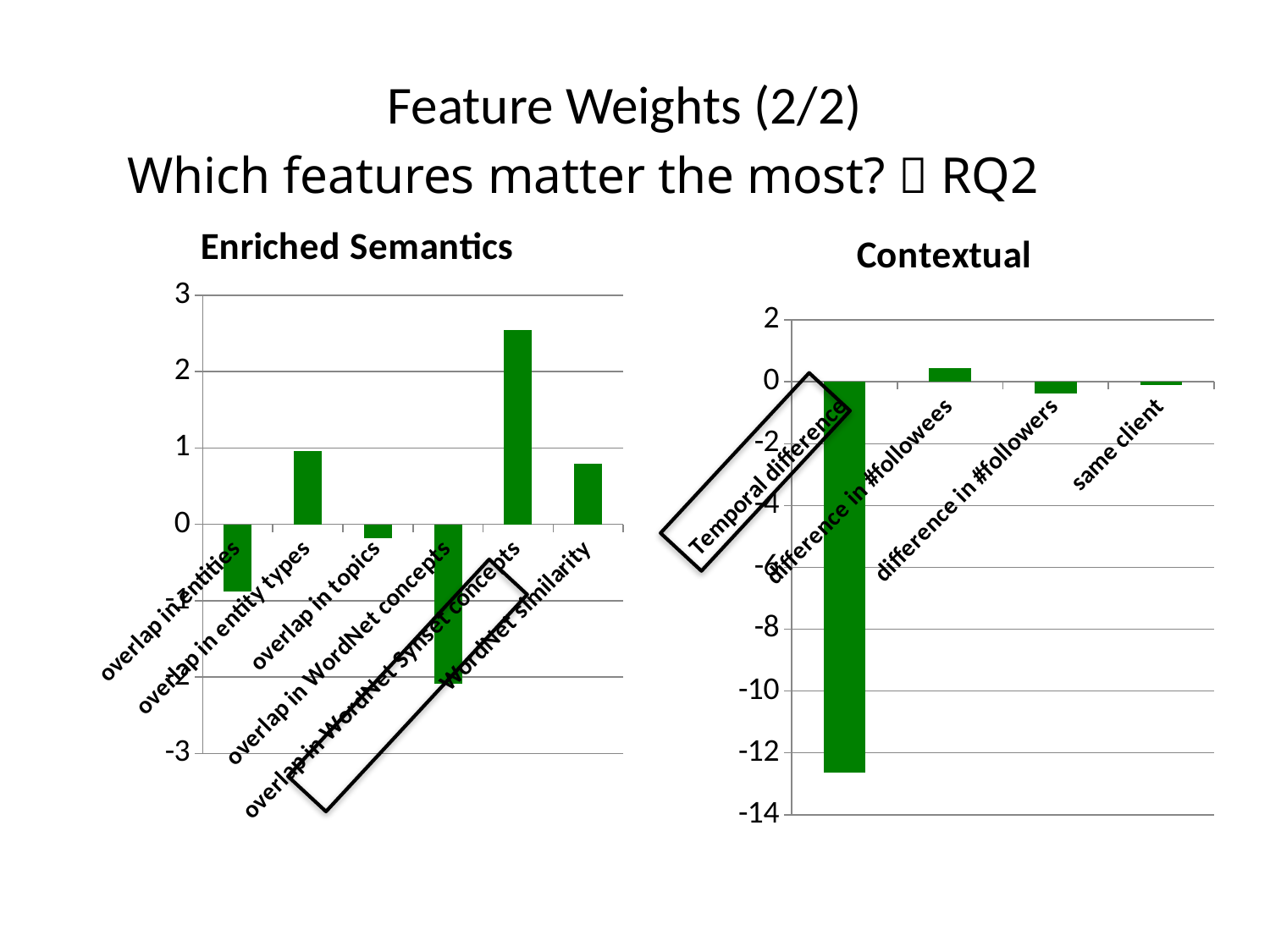
What kind of chart is the Enriched Semantics chart? bar chart In the Contextual chart, which category has the lowest value? Temporal difference In the Contextual chart, which category has the highest value? difference in #followees In the Contextual chart, is the value for Temporal difference greater or less than -10? less In the Enriched Semantics chart, which category has the highest value? overlap in WordNet Synset concepts In the Enriched Semantics chart, which category has the lowest value? overlap in WordNet concepts How many categories are plotted in the Contextual chart? 4 In the Enriched Semantics chart, is the value for overlap in WordNet concepts greater or less than -1? less What is the title of the chart on the right side of the slide? Contextual In the Enriched Semantics chart, is the value for overlap in WordNet Synset concepts greater or less than 2? greater In the Contextual chart, which is larger: the value for difference in #followees or the value for difference in #followers? difference in #followees How many categories are plotted in the Enriched Semantics chart? 6